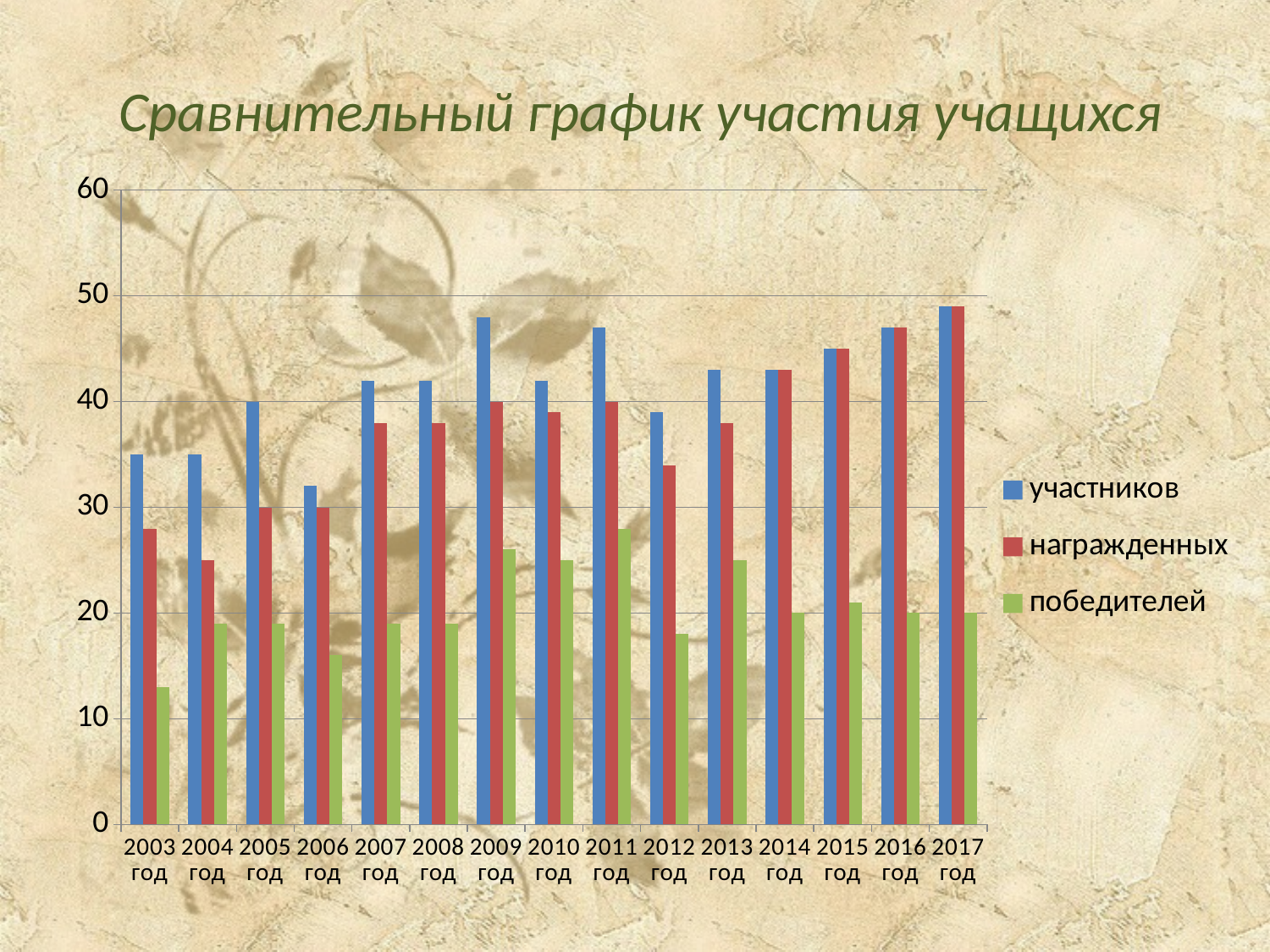
How many years are shown on the x axis? 15 Is the value for участников in 2003 год greater or less than 30? greater Which is larger, the value for награжденных in 2009 год or in 2012 год? 2009 год Is the value for победителей in 2011 год greater or less than 20? greater Which year has the lowest value for участников? 2006 год How many series does the legend list? 3 What is the title of the chart? Сравнительный график участия учащихся Is the value for участников in 2009 год greater or less than 50? less Which is larger, the value for участников in 2005 год or in 2006 год? 2005 год Which year has the lowest value for победителей? 2003 год What kind of chart is shown on the slide? bar chart